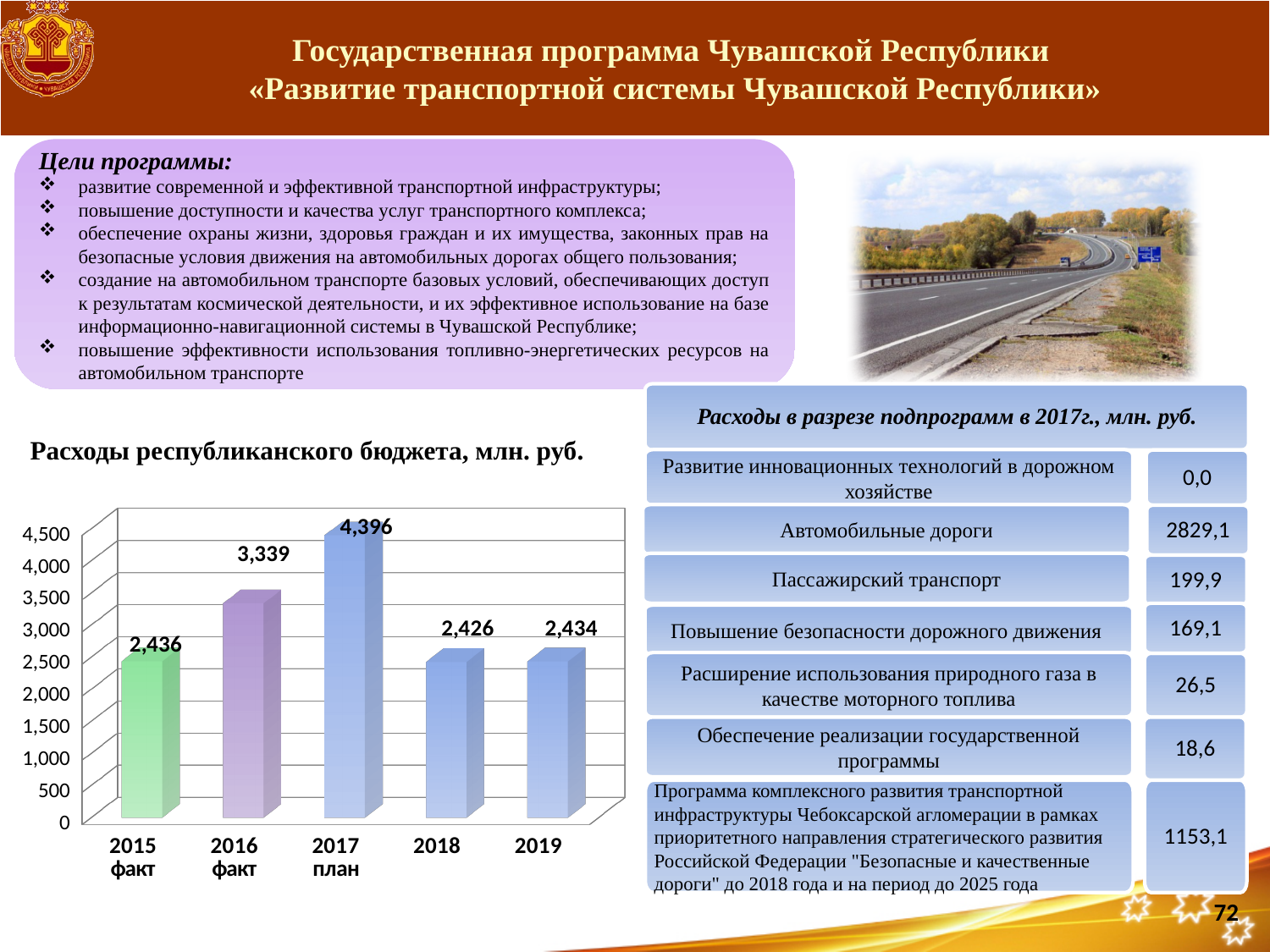
What is the difference between the 2017 план and 2016 факт values in the chart 'Расходы республиканского бюджета, млн. руб.'? 1,057 In the chart 'Расходы республиканского бюджета, млн. руб.', do the values rise or fall from 2015 факт to 2017 план? rise What is the value for 2019 in the chart 'Расходы республиканского бюджета, млн. руб.'? 2,434 What type of chart is 'Расходы республиканского бюджета, млн. руб.'? bar chart How many bars are shown in the chart 'Расходы республиканского бюджета, млн. руб.'? 5 Which year has the lowest value in the chart 'Расходы республиканского бюджета, млн. руб.'? 2018 In the chart 'Расходы республиканского бюджета, млн. руб.', which is larger: the value for 2016 факт or the value for 2018? 2016 факт In the chart 'Расходы республиканского бюджета, млн. руб.', is the value for 2016 факт greater or less than 3,000? greater Which year has the highest value in the chart 'Расходы республиканского бюджета, млн. руб.'? 2017 план What is the difference between the 2016 факт and 2015 факт values in the chart 'Расходы республиканского бюджета, млн. руб.'? 903 What is the value for 2015 факт in the chart 'Расходы республиканского бюджета, млн. руб.'? 2,436 What is the value for 2017 план in the chart 'Расходы республиканского бюджета, млн. руб.'? 4,396